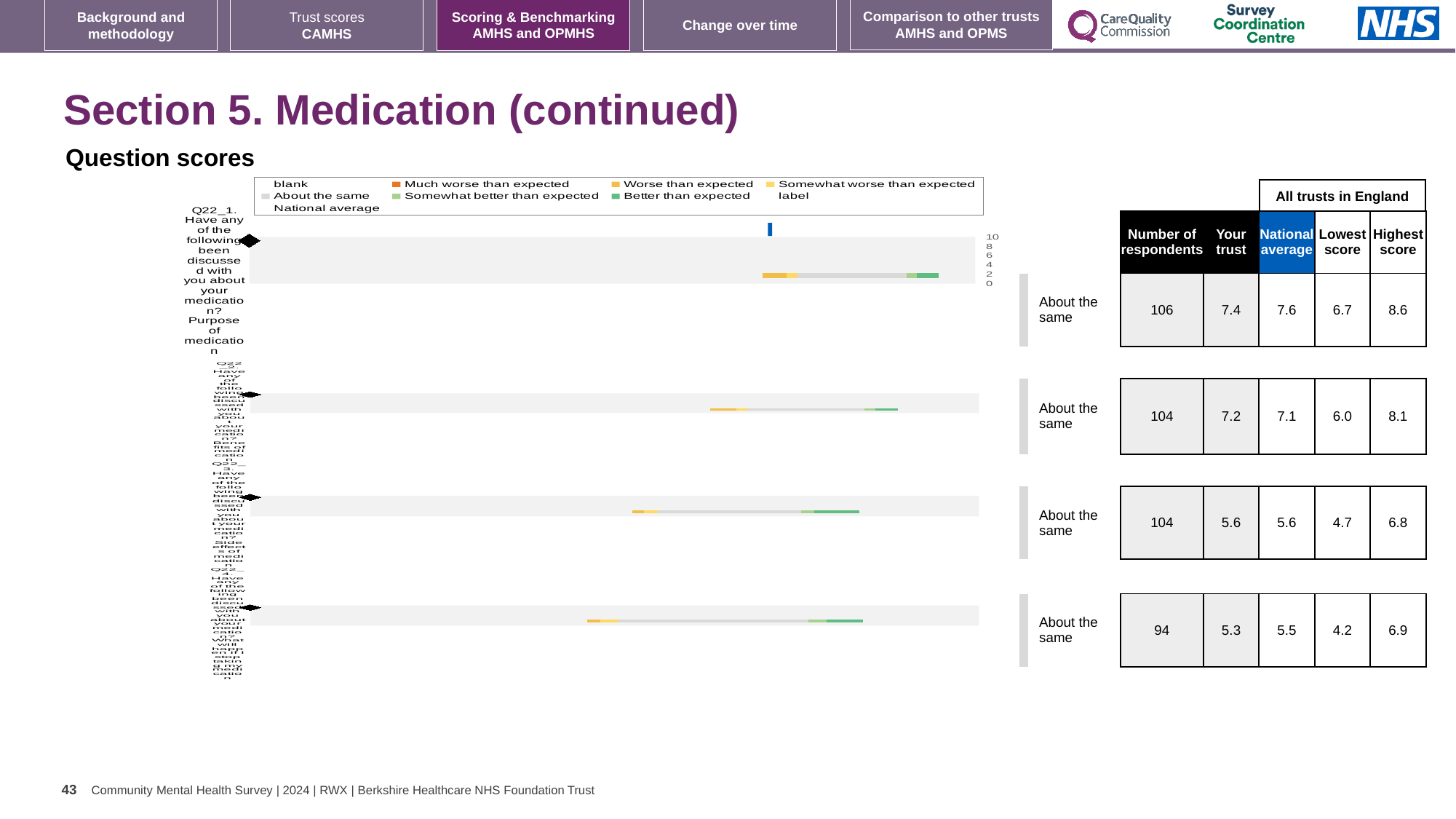
What colour does the legend use for 'Better than expected'? green In the table beside the chart, what is the difference between the highest score and the lowest score for the first row (Q22_1)? 1.9 In the table beside the chart, what is the lowest score for the fourth row? 4.2 What is the highest tick value shown on the chart's axis? 10 In the table beside the chart, which row has the highest 'Your trust' score? the first row (Q22_1) How many question rows (bars) does the chart show? 4 In the table beside the chart, what is the 'Your trust' score for the first row (Q22_1)? 7.4 What kind of chart is shown on the slide? bar chart What colour does the legend use for 'Much worse than expected'? orange In the table beside the chart, which row has the fewest respondents? the fourth row In the table beside the chart, what is the national average for the third row? 5.6 In the table beside the chart, what is the number of respondents for the first row (Q22_1, purpose of medication)? 106